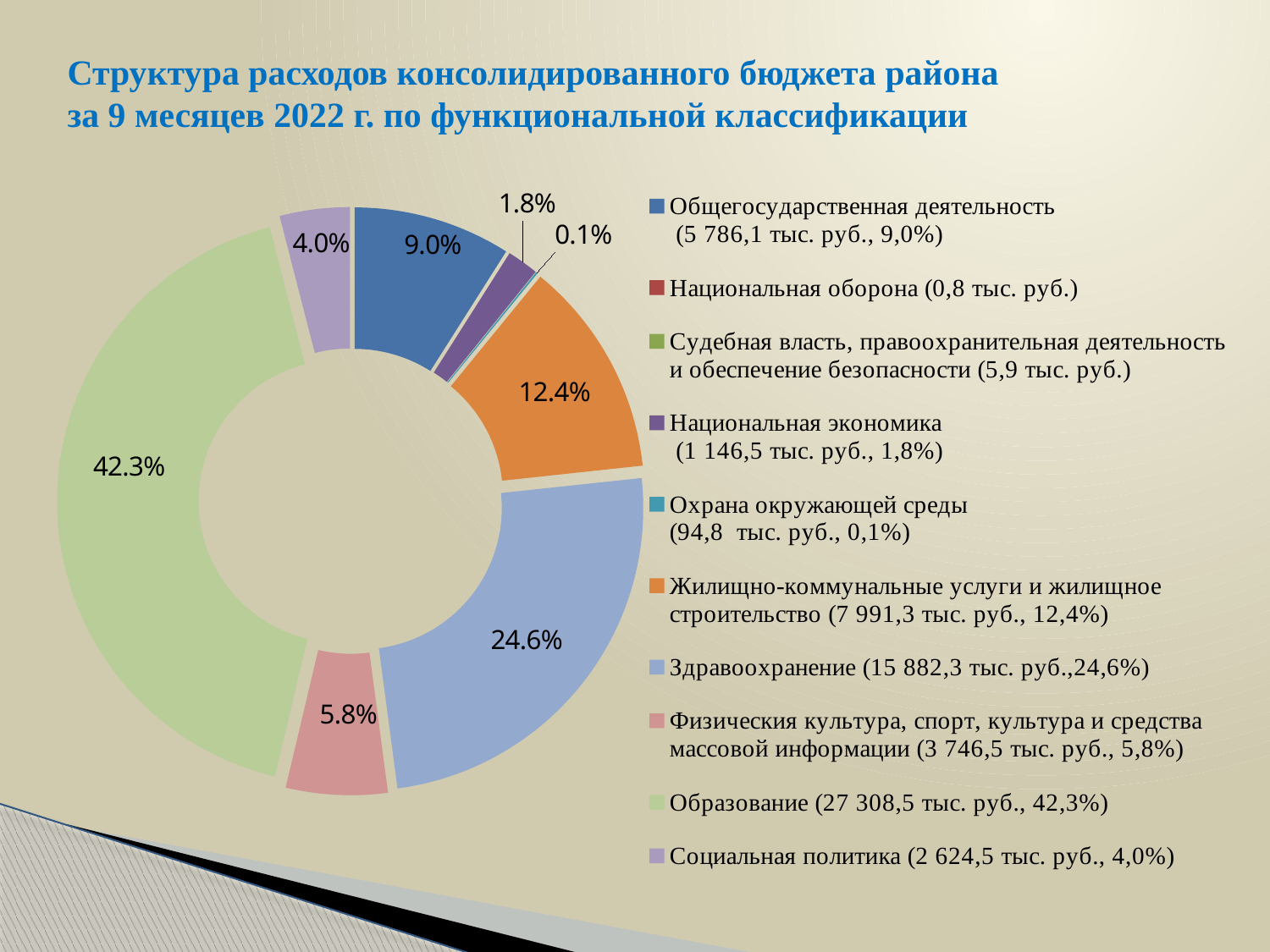
What share of the chart does Здравоохранение account for? 24.6% What is the difference in percentage points between the share for Общегосударственная деятельность and the share for Физическия культура, спорт, культура и средства массовой информации? 3.2 What amount in thousand rubles is given in the legend for Здравоохранение? 15 882,3 тыс. руб. What share of the chart does Образование account for? 42.3% What is the difference in percentage points between the share for Образование and the share for Здравоохранение? 17.7 How many entries does the legend list? 10 Which is larger: the share for Здравоохранение or the share for Жилищно-коммунальные услуги и жилищное строительство? Здравоохранение What share of the chart does Социальная политика account for? 4.0% What is the title of the slide? Структура расходов консолидированного бюджета района за 9 месяцев 2022 г. по функциональной классификации What kind of chart is shown on the slide? Doughnut chart Which category has the largest share of the chart? Образование What share of the chart does Жилищно-коммунальные услуги и жилищное строительство account for? 12.4%